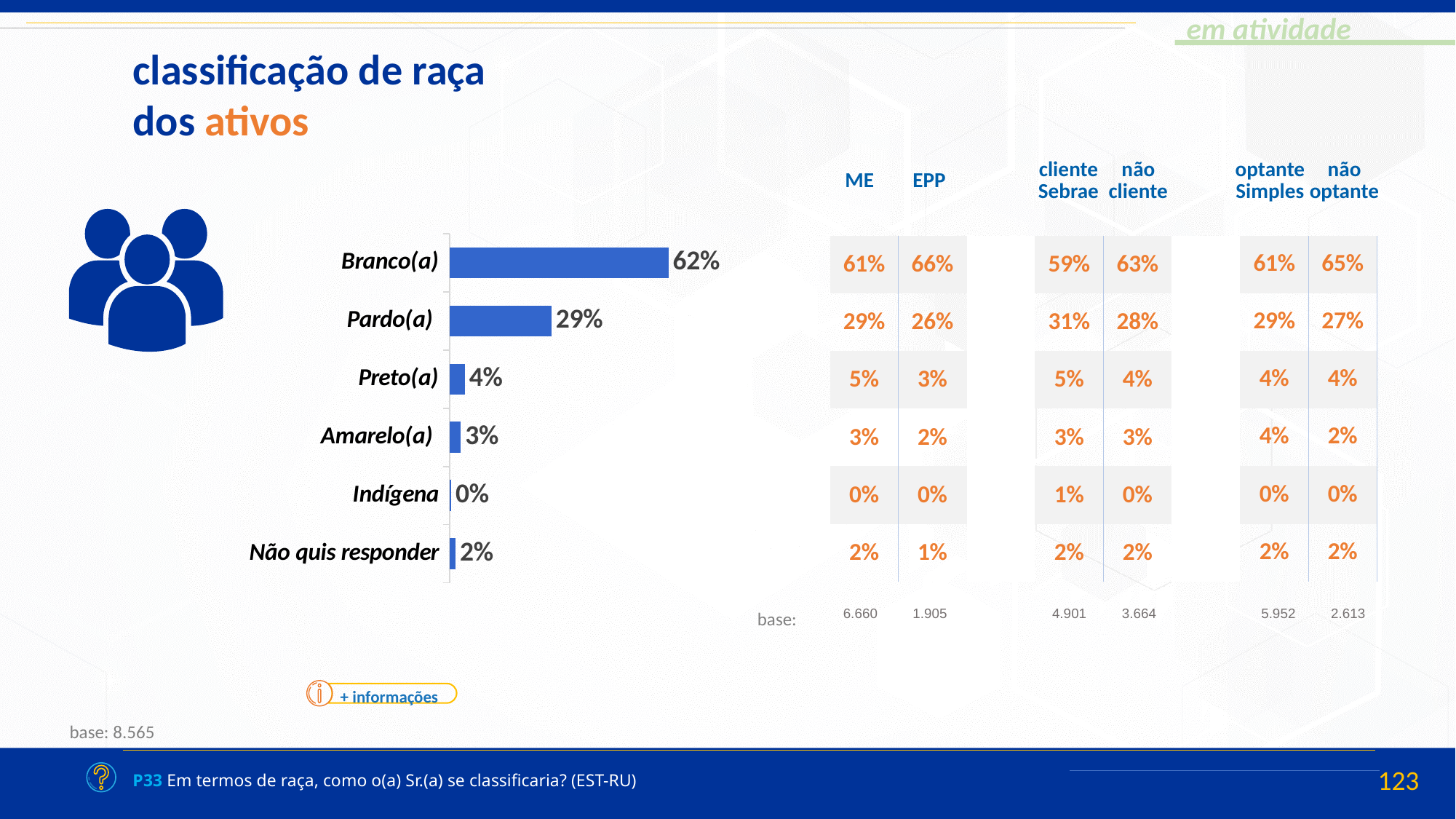
What is the value for Não quis responder in the bar chart? 2% Which category has the highest value in the bar chart? Branco(a) Which is larger in the bar chart, the value for Preto(a) or the value for Amarelo(a)? Preto(a) What kind of chart is shown on the slide? Bar chart How many categories are shown in the bar chart? 6 What is the value for Branco(a) in the bar chart? 62% Which category has the lowest value in the bar chart? Indígena What is the difference between the values for Branco(a) and Pardo(a) in the bar chart? 33% What is the value for Pardo(a) in the bar chart? 29% What is the value for Preto(a) in the bar chart? 4% What is the base (sample size) shown below the bar chart? 8.565 What is the difference between the values for Amarelo(a) and Não quis responder in the bar chart? 1%